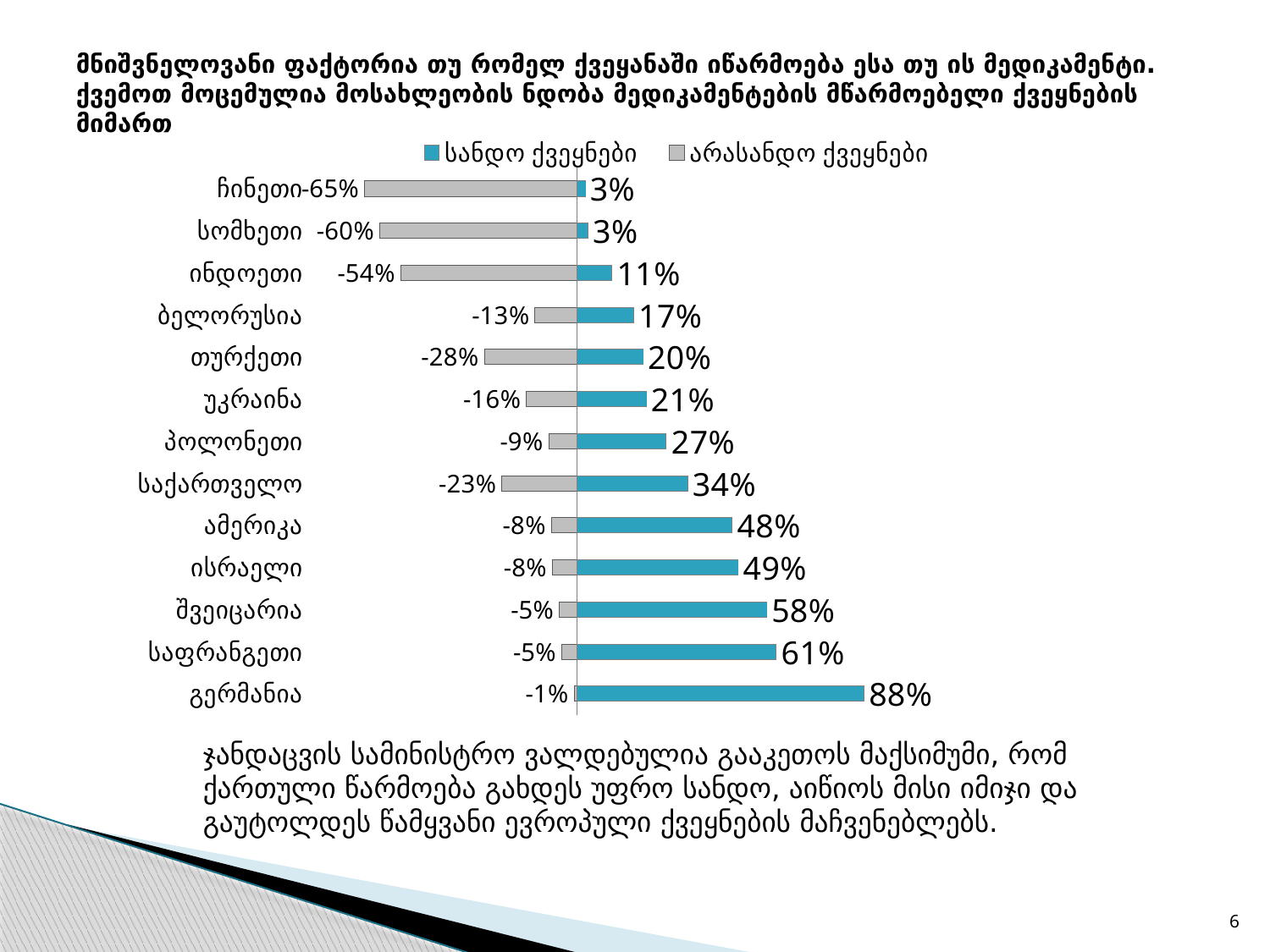
Which colour represents the სანდო ქვეყნები series in the chart? Blue What is the value of the არასანდო ქვეყნები series for ჩინეთი? -65% How many series does the legend list? 2 Which category has the highest value in the სანდო ქვეყნები series? გერმანია Which category has the lowest value in the არასანდო ქვეყნები series? ჩინეთი What is the value of the სანდო ქვეყნები series for საქართველო? 34% What is the value of the არასანდო ქვეყნები series for თურქეთი? -28% Which has a larger სანდო ქვეყნები value, ამერიკა or პოლონეთი? ამერიკა What kind of chart is shown on the slide? Bar chart How many categories (countries) are shown in the chart? 13 What is the value of the სანდო ქვეყნები series for გერმანია? 88% What is the difference between the სანდო ქვეყნები values for გერმანია and საფრანგეთი? 27%